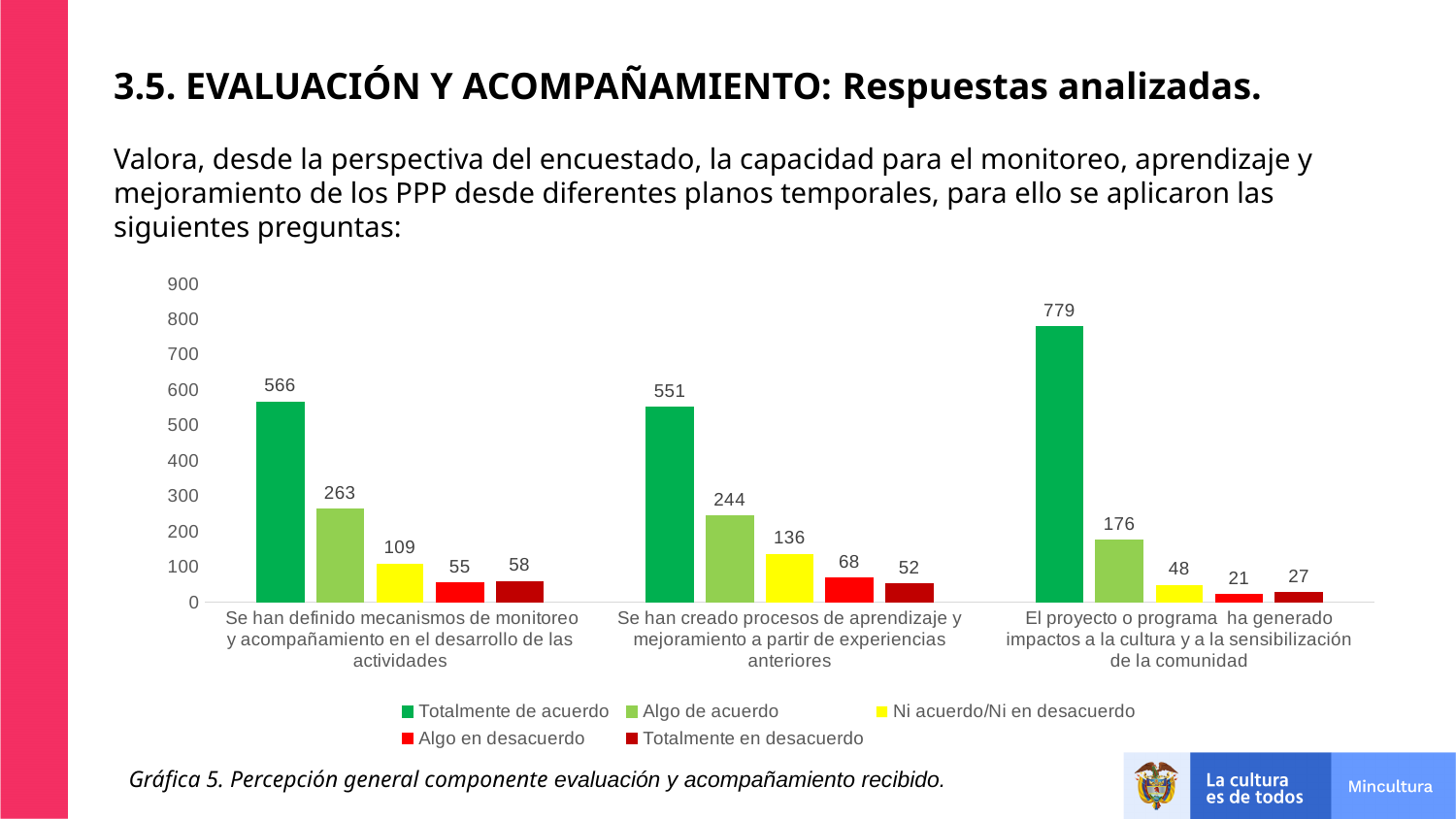
Which series has the lowest value in the category "El proyecto o programa ha generado impactos a la cultura y a la sensibilización de la comunidad"? Algo en desacuerdo How many series does the legend list? 5 Which is larger: "Algo en desacuerdo" or "Totalmente en desacuerdo" in the category "Se han creado procesos de aprendizaje y mejoramiento a partir de experiencias anteriores"? Algo en desacuerdo What kind of chart is shown on the slide? Bar chart What is the difference between the "Totalmente de acuerdo" values for "Se han definido mecanismos de monitoreo y acompañamiento en el desarrollo de las actividades" and "Se han creado procesos de aprendizaje y mejoramiento a partir de experiencias anteriores"? 15 How many categories are shown on the x axis of the chart? 3 Which category has the highest value for "Totalmente de acuerdo"? El proyecto o programa ha generado impactos a la cultura y a la sensibilización de la comunidad Is the value for "Algo de acuerdo" in the category "El proyecto o programa ha generado impactos a la cultura y a la sensibilización de la comunidad" greater or less than 200? less What is the value for "Totalmente de acuerdo" in the category "El proyecto o programa ha generado impactos a la cultura y a la sensibilización de la comunidad"? 779 What is the value for "Algo de acuerdo" in the category "Se han creado procesos de aprendizaje y mejoramiento a partir de experiencias anteriores"? 244 What is the value for "Ni acuerdo/Ni en desacuerdo" in the category "Se han definido mecanismos de monitoreo y acompañamiento en el desarrollo de las actividades"? 109 What colour are the bars for "Ni acuerdo/Ni en desacuerdo"? Yellow